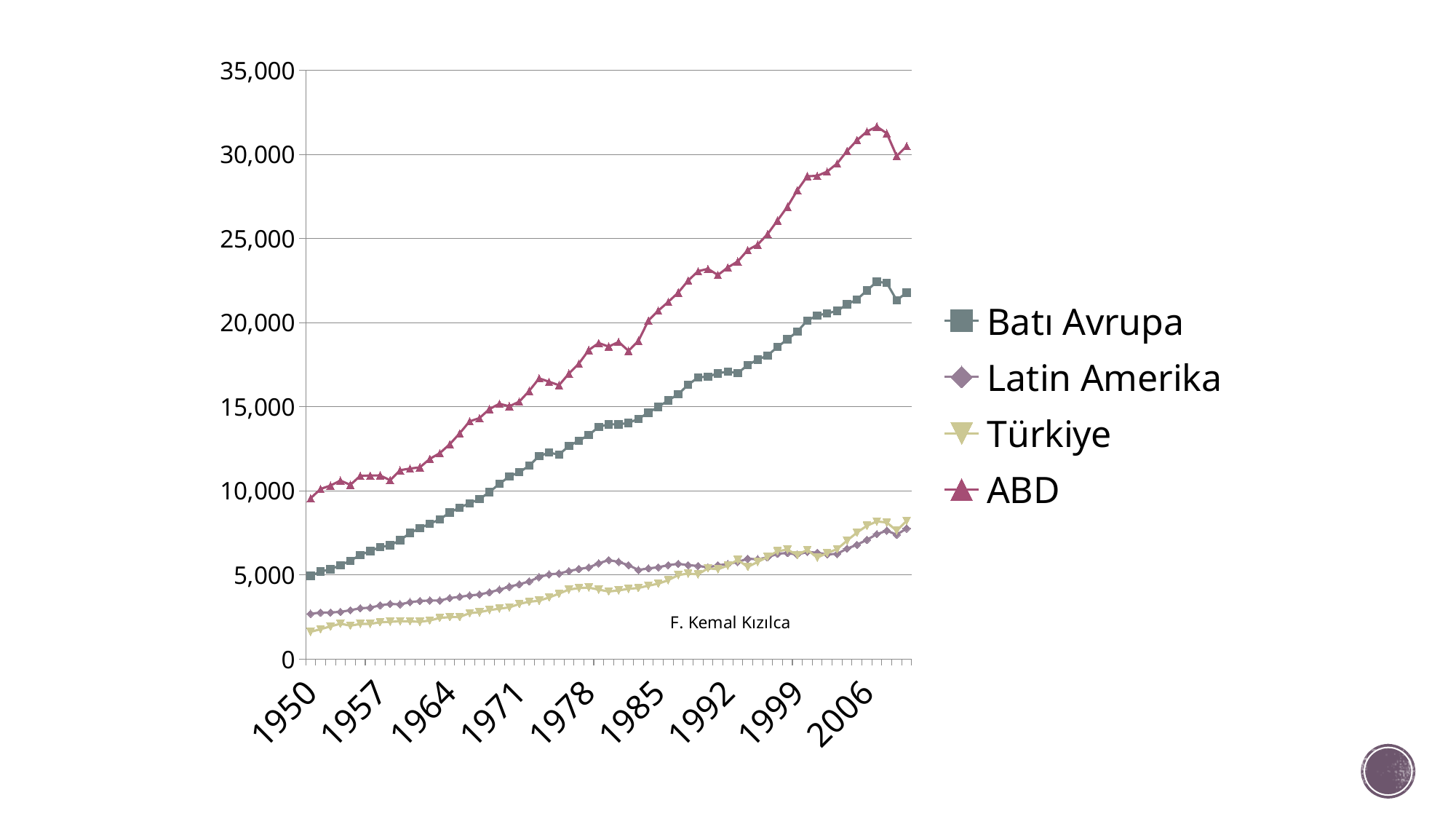
How many series does the legend list? 4 Is the value for Türkiye in 1950 greater or less than 5,000? less In 1999, which is larger: ABD or Batı Avrupa? ABD In 1992, which is larger: Batı Avrupa or Latin Amerika? Batı Avrupa Is the value for ABD in 1985 greater or less than 15,000? greater Is the value for Batı Avrupa in 1950 greater or less than 10,000? less Which series has the lowest value in 1950? Türkiye What kind of chart is shown on the slide? line chart Does the ABD series generally rise or fall from 1950 to 2006? rise How many year labels are shown on the x axis? 9 Which series has the highest value in 1950? ABD